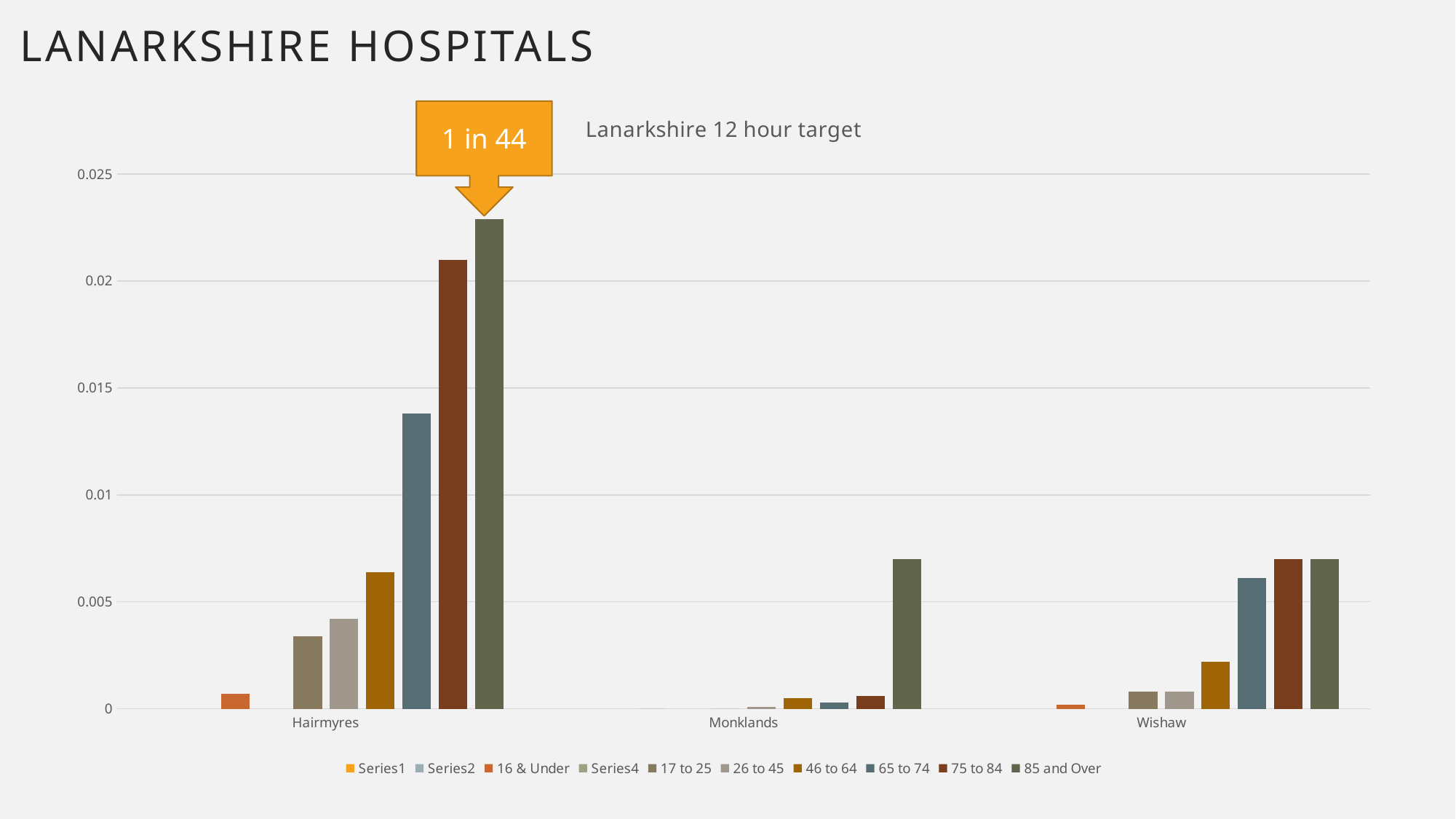
Is the value for 85 and Over at Monklands greater or less than 0.005? greater How many series does the chart legend list? 10 Is the value for 17 to 25 at Hairmyres greater or less than 0.005? less How many hospitals are shown on the x axis of the chart? 3 Is the value for 85 and Over at Hairmyres greater or less than 0.02? greater Which hospital has the highest value for the 85 and Over series? Hairmyres What figure is shown in the orange callout pointing at the tallest bar? 1 in 44 Which is larger: the 65 to 74 value at Wishaw or the 65 to 74 value at Monklands? Wishaw Within the Hairmyres group, do the bars rise or fall going from the 17 to 25 series to the 85 and Over series? rise Which is larger: the 75 to 84 value at Hairmyres or the 75 to 84 value at Wishaw? Hairmyres What kind of chart is shown on the slide? bar chart